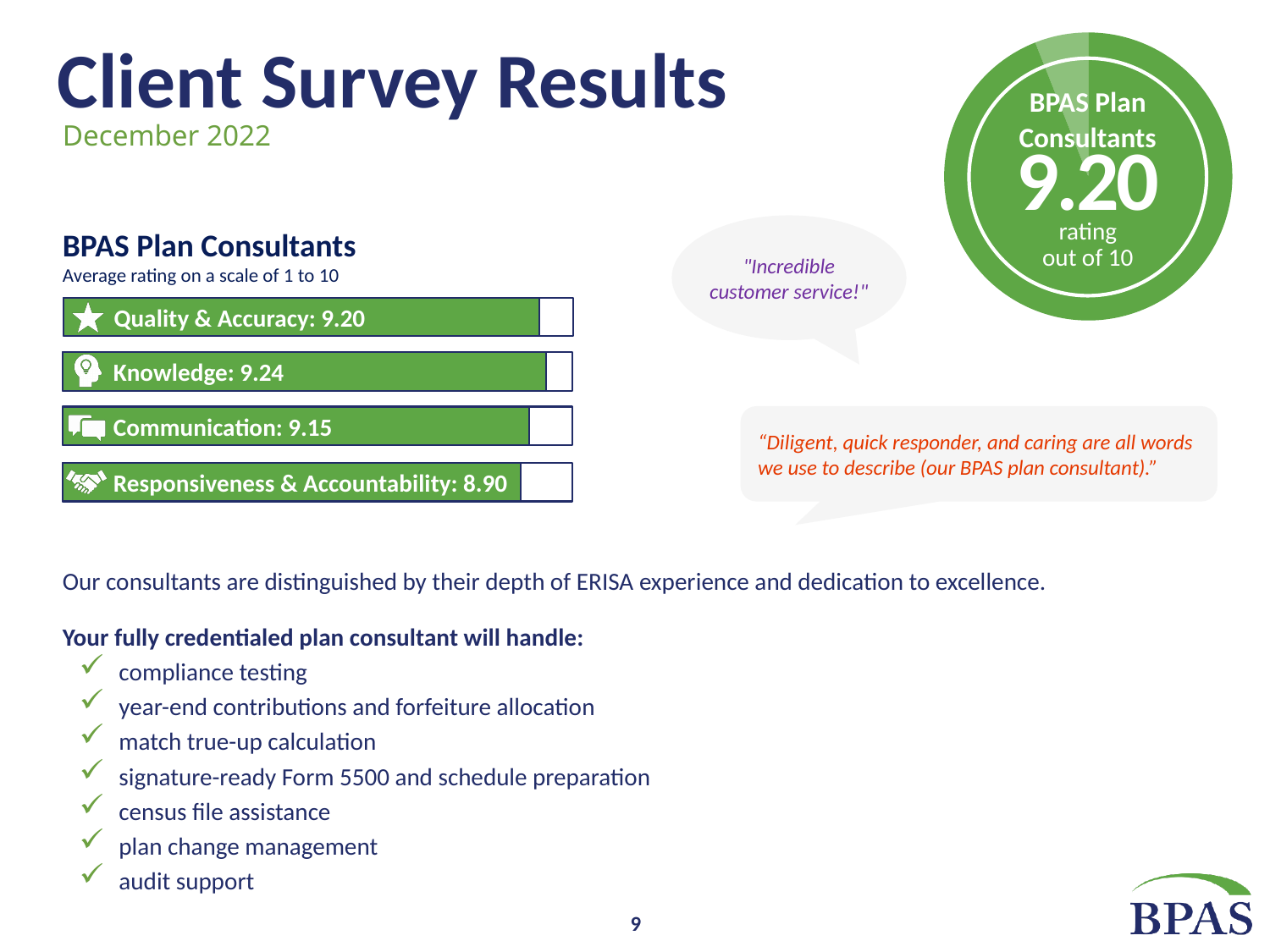
How many rating categories are shown in the bar chart? 4 What is the average rating for Knowledge in the BPAS Plan Consultants chart? 9.24 Which category has the highest average rating? Knowledge What is the average rating for Communication? 9.15 What is the difference between the Knowledge rating and the Responsiveness & Accountability rating? 0.34 Which is rated higher, Quality & Accuracy or Communication? Quality & Accuracy Which category has the lowest average rating? Responsiveness & Accountability What kind of chart is used to show the BPAS Plan Consultants ratings? Bar chart On what scale are the average ratings in the chart measured? 1 to 10 What is the average rating for Responsiveness & Accountability? 8.90 What is the overall BPAS Plan Consultants rating shown in the green circle? 9.20 What is the average rating for Quality & Accuracy? 9.20